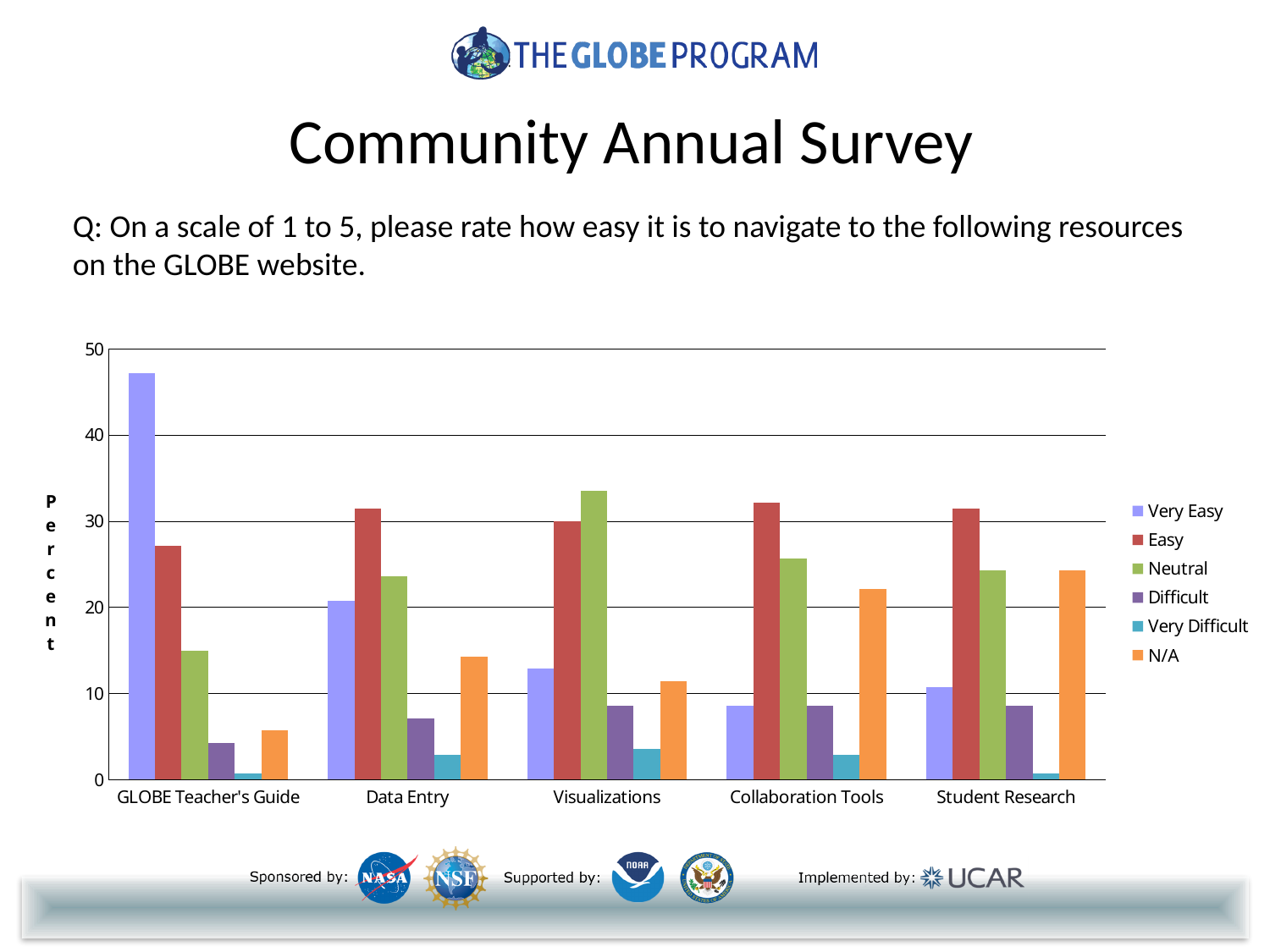
Which resource has the highest Very Easy percentage? GLOBE Teacher's Guide Is the Very Easy value for GLOBE Teacher's Guide greater or less than 40? greater Which resource has the highest Neutral percentage? Visualizations How many series does the chart's legend list? 6 For Visualizations, which is larger: the Neutral value or the Easy value? Neutral For GLOBE Teacher's Guide, which is larger: the Very Easy value or the Easy value? Very Easy What is the label on the vertical axis of the chart? Percent Is the N/A value for Collaboration Tools greater or less than 20? greater Is the Easy value for Data Entry greater or less than 30? greater How many resource categories are shown along the x axis of the chart? 5 What kind of chart is shown on the slide? Bar chart Which resource has the lowest Very Easy percentage? Collaboration Tools